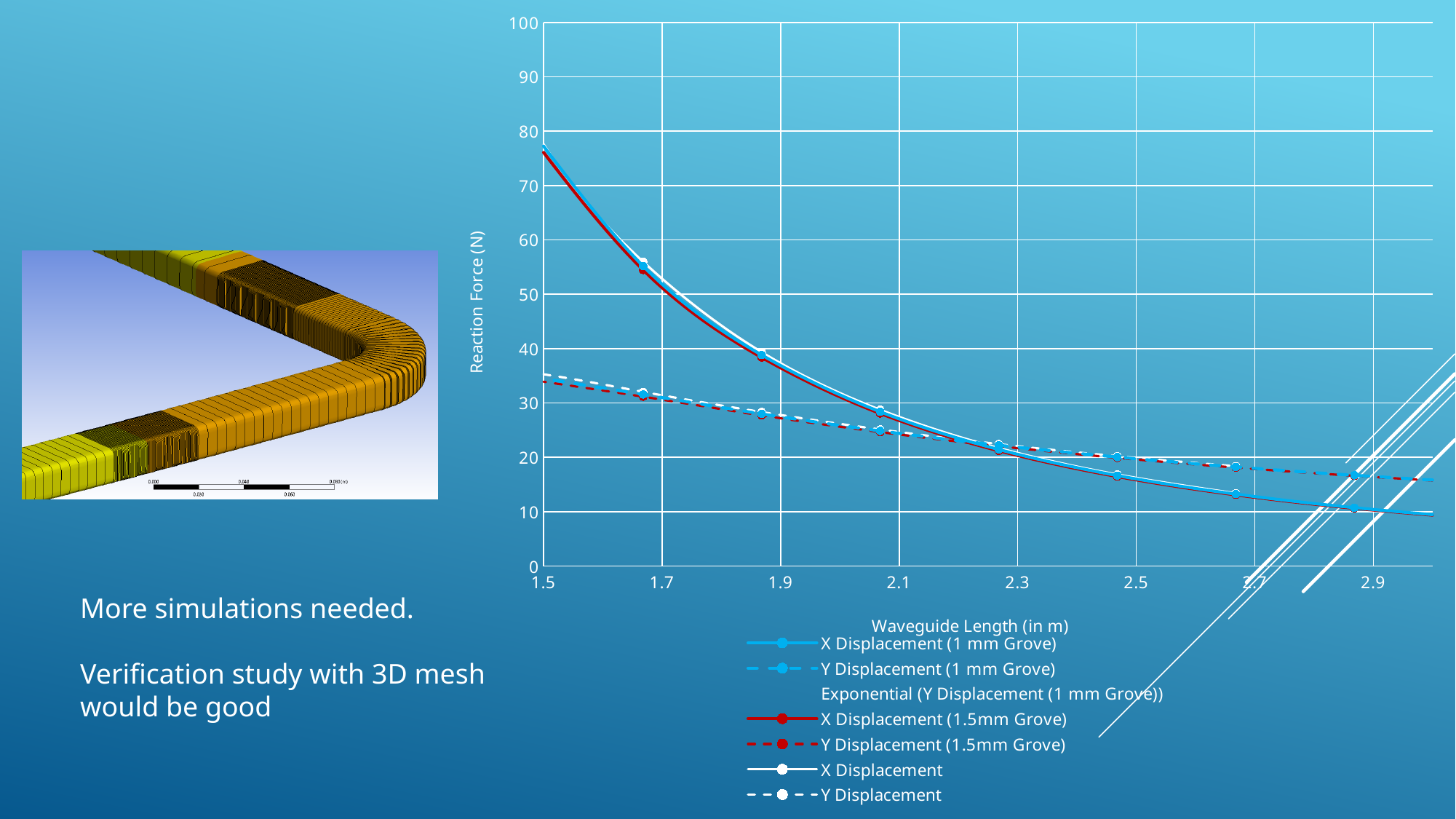
At a waveguide length of 1.5 m, which has the larger reaction force: X Displacement (1 mm Grove) or Y Displacement (1 mm Grove)? X Displacement (1 mm Grove) What is the label of the horizontal axis of the chart? Waveguide Length (in m) At a waveguide length of 1.5 m, is the reaction force for Y Displacement (1 mm Grove) greater or less than 40? less Does the reaction force for Y Displacement (1.5mm Grove) rise or fall as waveguide length increases? fall At a waveguide length of 1.5 m, is the reaction force for X Displacement (1 mm Grove) greater or less than 70? greater What kind of chart is shown on the slide? line chart At a waveguide length of 2.9 m, which has the larger reaction force: X Displacement (1.5mm Grove) or Y Displacement (1.5mm Grove)? Y Displacement (1.5mm Grove) How many series does the chart legend list? 7 At a waveguide length of 1.9 m, is the reaction force for X Displacement (1.5mm Grove) greater or less than 30? greater Does the reaction force for X Displacement (1 mm Grove) rise or fall as waveguide length increases? fall What is the label of the vertical axis of the chart? Reaction Force (N)